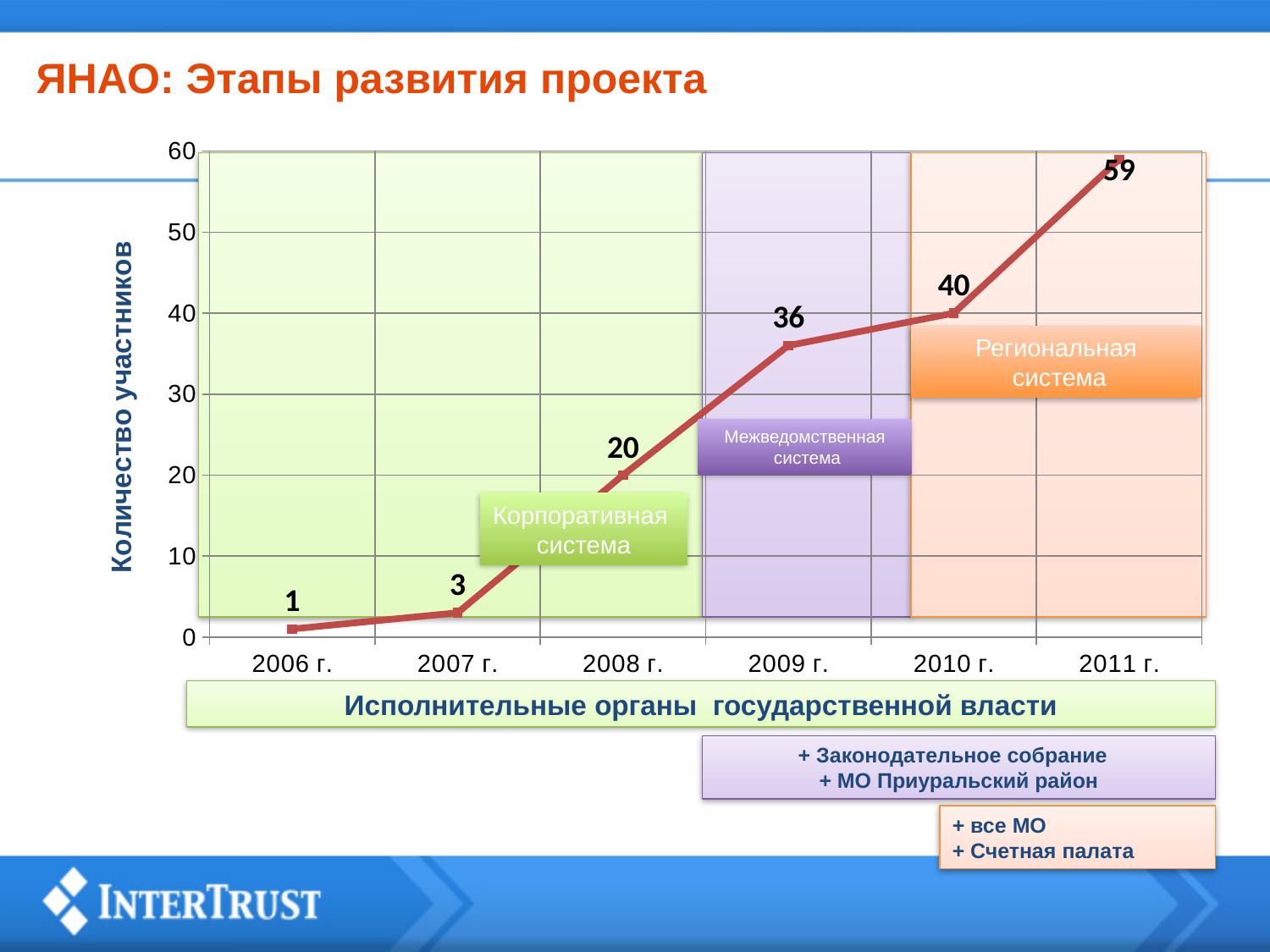
Which year has the highest number of participants? 2011 г. What is the number of participants in 2010 г.? 40 Which year has the lowest number of participants? 2006 г. What is the label of the y axis? Количество участников What is the difference in participants between 2009 г. and 2008 г.? 16 How many years are plotted on the x axis? 6 Which year has more participants, 2007 г. or 2009 г.? 2009 г. What is the number of participants in 2006 г.? 1 What is the difference in participants between 2011 г. and 2010 г.? 19 What kind of chart is shown on the slide? line chart What is the number of participants in 2008 г.? 20 Do the values rise or fall from 2006 г. to 2011 г.? rise